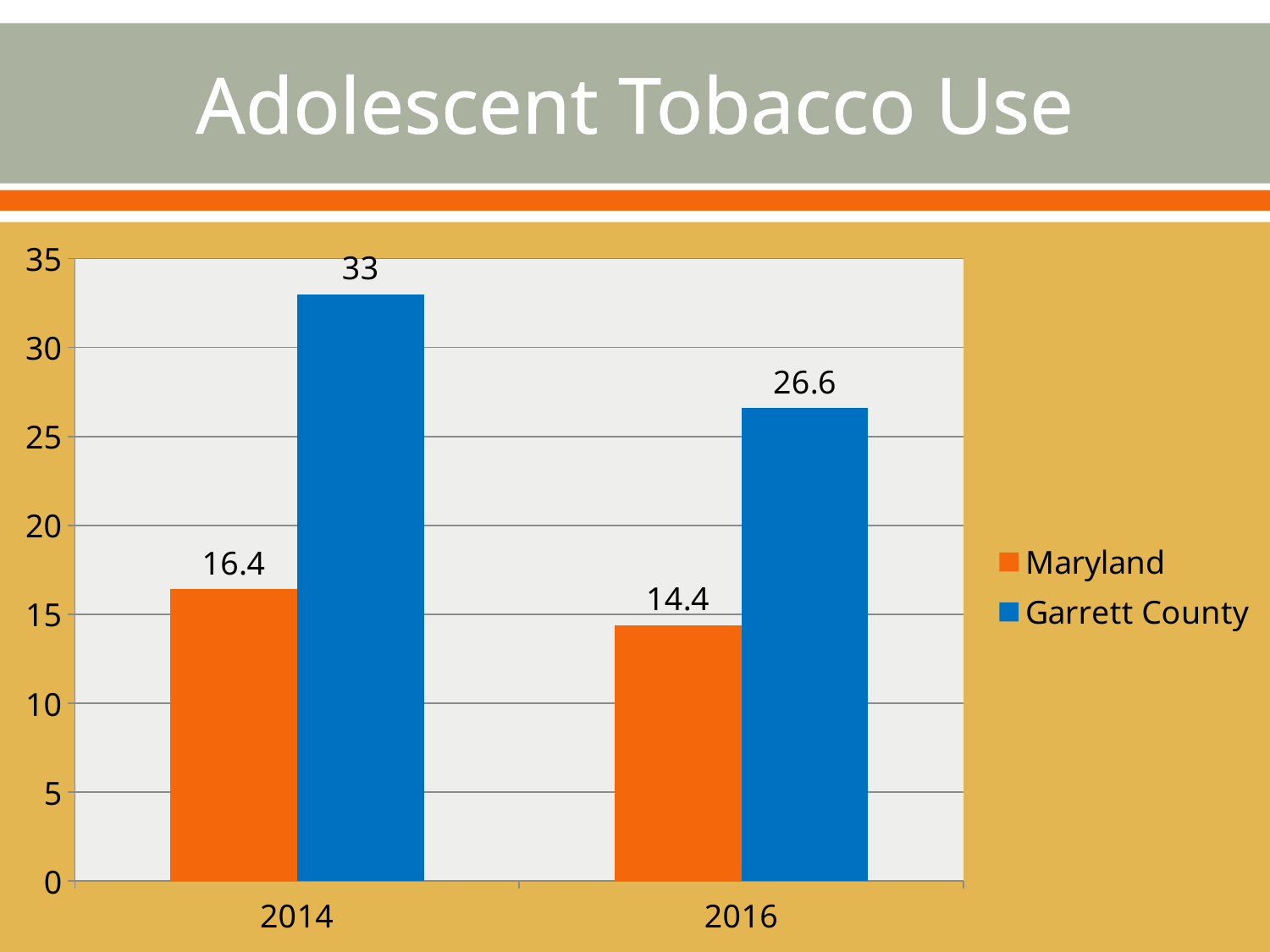
What is the value for Maryland in 2014? 16.4 Do the Maryland values rise or fall from 2014 to 2016? fall What is the difference between the Garrett County values in 2014 and 2016? 6.4 How many series does the legend list? 2 What is the value for Garrett County in 2016? 26.6 What is the value for Garrett County in 2014? 33 Which year has the highest value for Garrett County? 2014 Which year has the lowest value for Maryland? 2016 What is the difference between the Garrett County and Maryland values in 2014? 16.6 In 2016, which is larger, the value for Maryland or the value for Garrett County? Garrett County What kind of chart is shown on the slide? bar chart What is the value for Maryland in 2016? 14.4